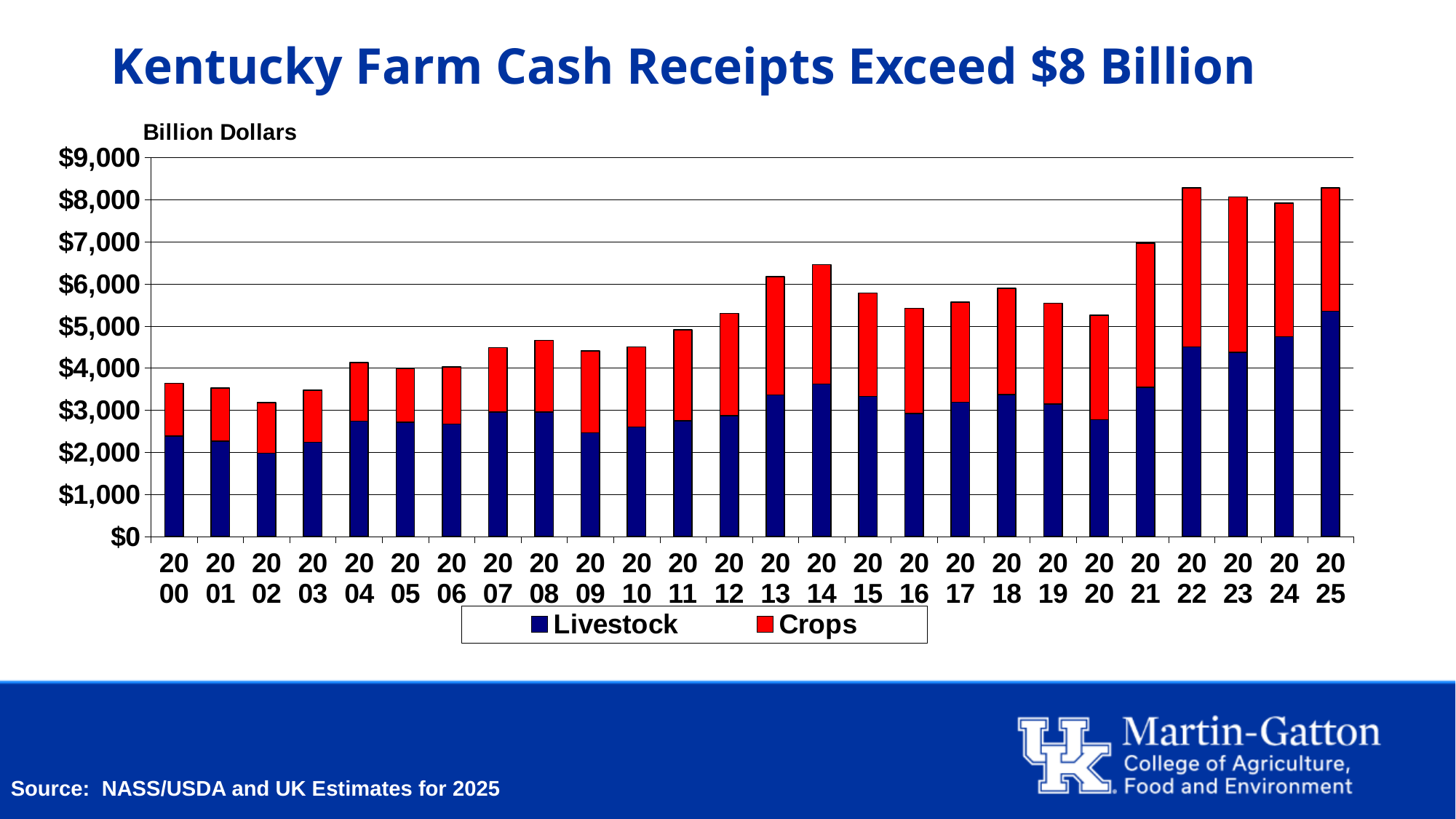
Which year has the lowest total farm cash receipts? 2002 Overall, do total farm cash receipts rise or fall from 2000 to 2025? Rise Which year has the larger total, 2000 or 2002? 2000 How many series does the legend list? 2 Is the total bar for 2002 greater or less than $4,000? less What kind of chart is shown on the slide? Stacked bar chart Is the Livestock value for 2025 greater or less than $5,000? greater How many years are plotted along the x axis? 26 Which series is shown in red in the legend? Crops Is the total bar for 2021 greater or less than $6,000? greater Which year has the larger total, 2014 or 2016? 2014